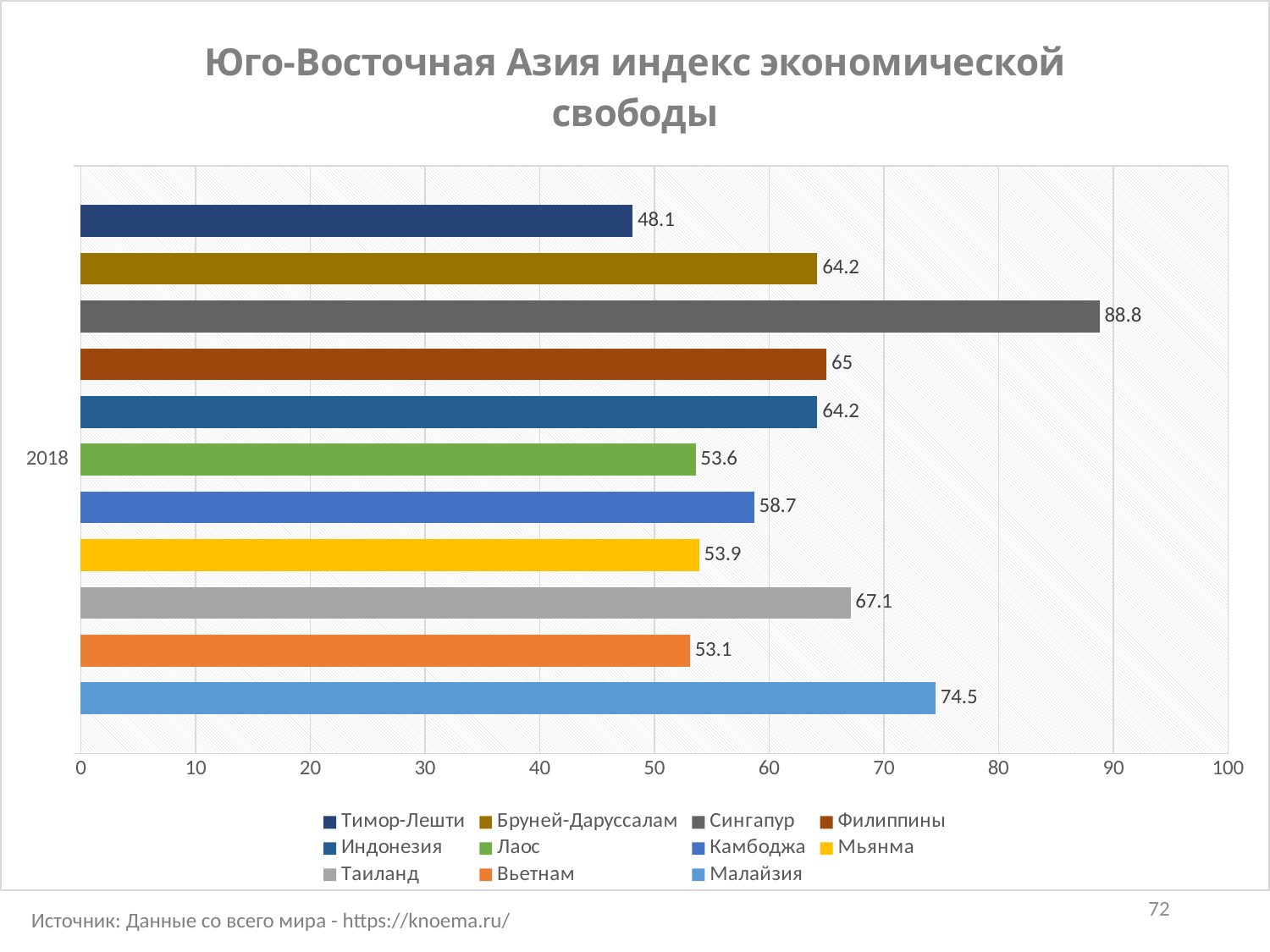
What is the value shown for Малайзия? 74.5 What is the difference between the values for Сингапур and Малайзия? 14.3 What is the value shown for Таиланд? 67.1 What is the economic freedom index value for Сингапур in 2018? 88.8 Which has a higher value, Камбоджа or Вьетнам? Камбоджа How many series does the legend list? 11 Which country has the highest economic freedom index on the chart? Сингапур What is the value shown for Тимор-Лешти? 48.1 Which country has the lowest economic freedom index on the chart? Тимор-Лешти What kind of chart is shown on the slide? Bar chart What year is labelled on the vertical axis of the chart? 2018 Is the value for Филиппины greater or less than 60? greater